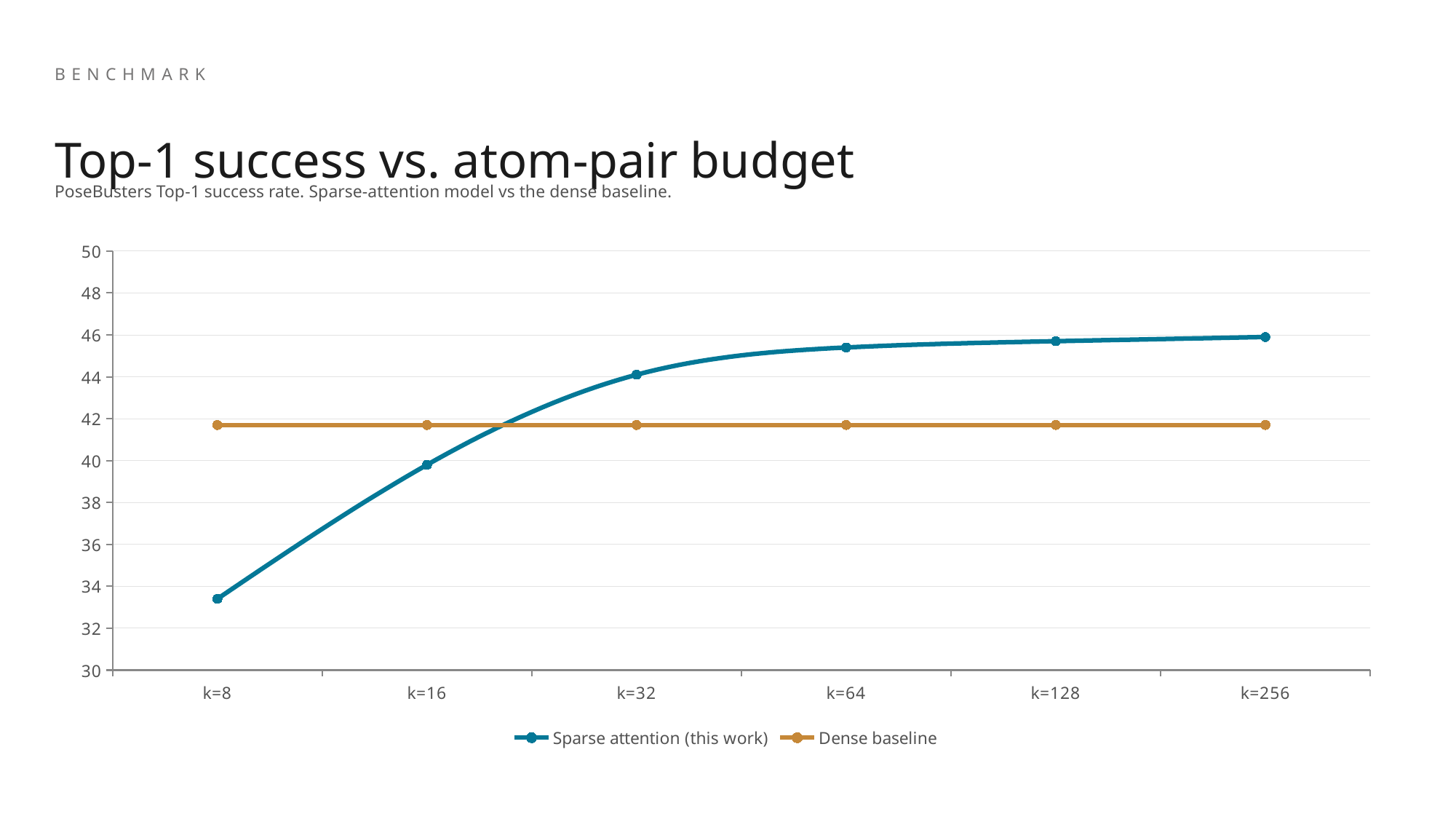
At k=64, which series has the larger value, Sparse attention (this work) or Dense baseline? Sparse attention (this work) At which k value is the Sparse attention (this work) series lowest? k=8 Is the Sparse attention (this work) value at k=8 greater or less than 36? less Is the Dense baseline value at k=128 greater or less than 40? greater How many series does the legend list? 2 How many k values are plotted along the x axis? 6 What is the title of the chart? Top-1 success vs. atom-pair budget What kind of chart is shown on the slide? line chart Does the Sparse attention (this work) series rise or fall as k increases from k=8 to k=256? rise Is the Sparse attention (this work) value at k=64 greater or less than 44? greater At k=8, which series has the larger value, Sparse attention (this work) or Dense baseline? Dense baseline